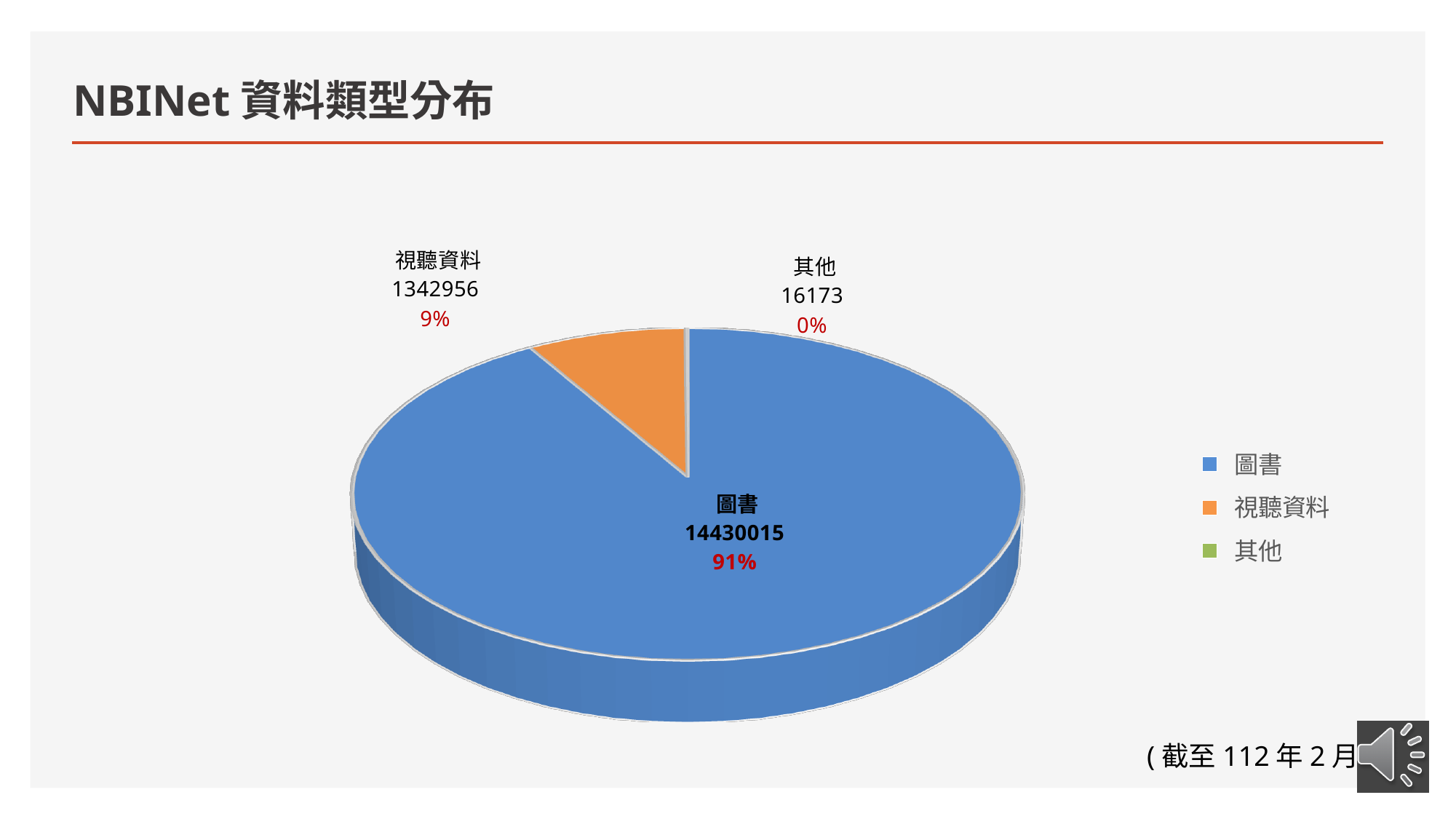
Which category has the largest slice in the pie chart? 圖書 What is the value for 其他 in the pie chart? 16173 Which is larger, the value for 視聽資料 or the value for 其他? 視聽資料 Which category has the smallest slice in the pie chart? 其他 What is the title of the chart on the slide? NBINet 資料類型分布 What is the value for 視聽資料 in the pie chart? 1342956 How many categories are shown in the pie chart? 3 What is the difference between the values for 圖書 and 視聽資料? 13087059 What share of the pie does 視聽資料 represent? 9% What is the value for 圖書 in the pie chart? 14430015 What share of the pie does 圖書 represent? 91% What kind of chart is shown on the slide? pie chart